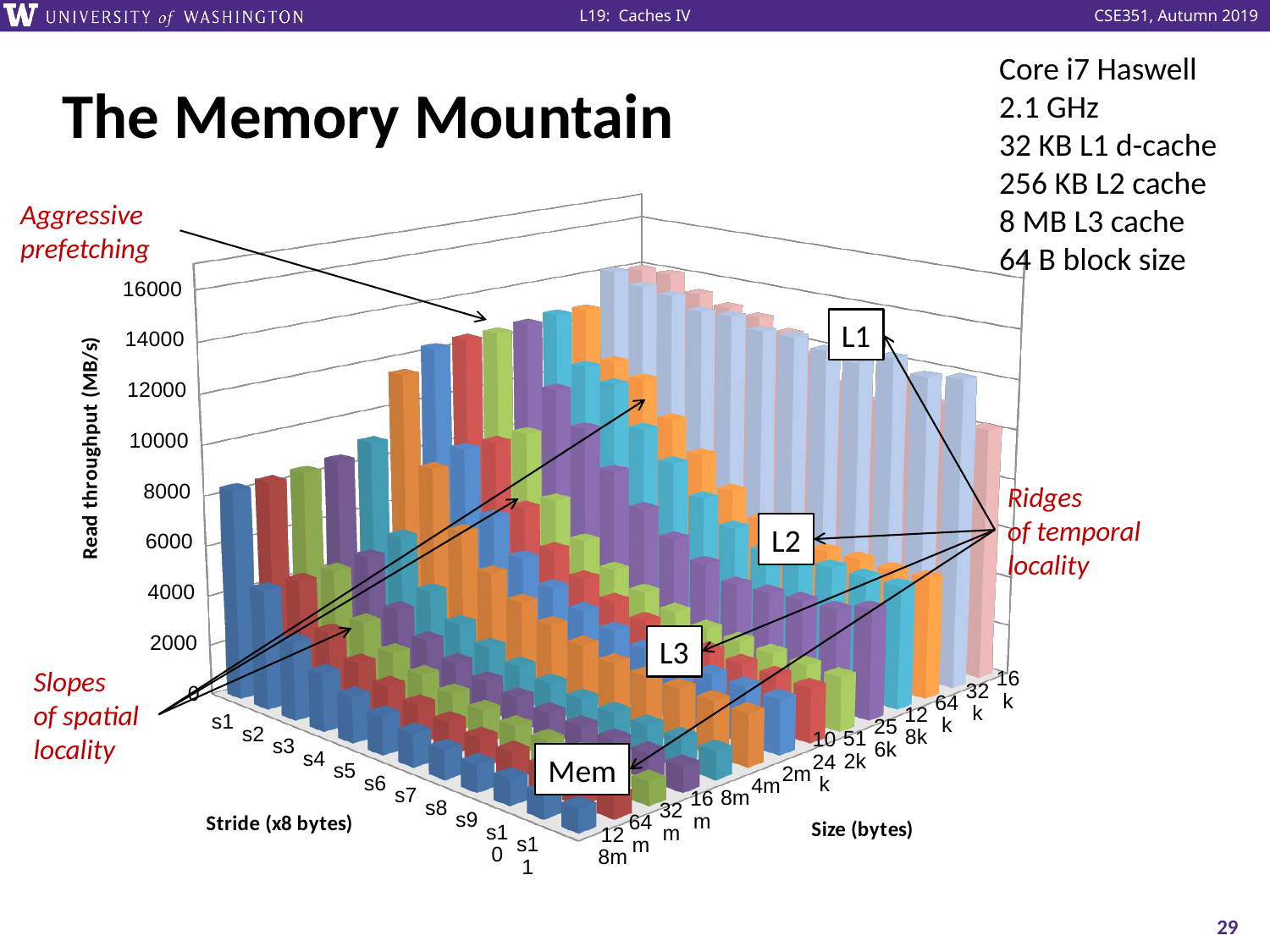
What is the highest tick value shown on the Read throughput axis? 16000 What is the label of the axis that runs from 8m to 16k? Size (bytes) What is the label of the vertical axis of the chart? Read throughput (MB/s) Which region of the chart is labelled with the lowest read throughput: L1, L2, L3 or Mem? Mem As the stride increases from s1 to s11, does read throughput generally rise or fall? fall What is the interval between consecutive ticks on the Read throughput axis? 2000 Are the tallest bars in the chart greater or less than 10000 MB/s? greater Which labelled region has higher read throughput, L1 or L3? L1 What kind of chart is shown on the slide? 3D bar chart What is the title of the slide containing the chart? The Memory Mountain Which stride category has the tallest bars overall? s1 How many stride categories (s1 through s11) are shown along the Stride axis? 11